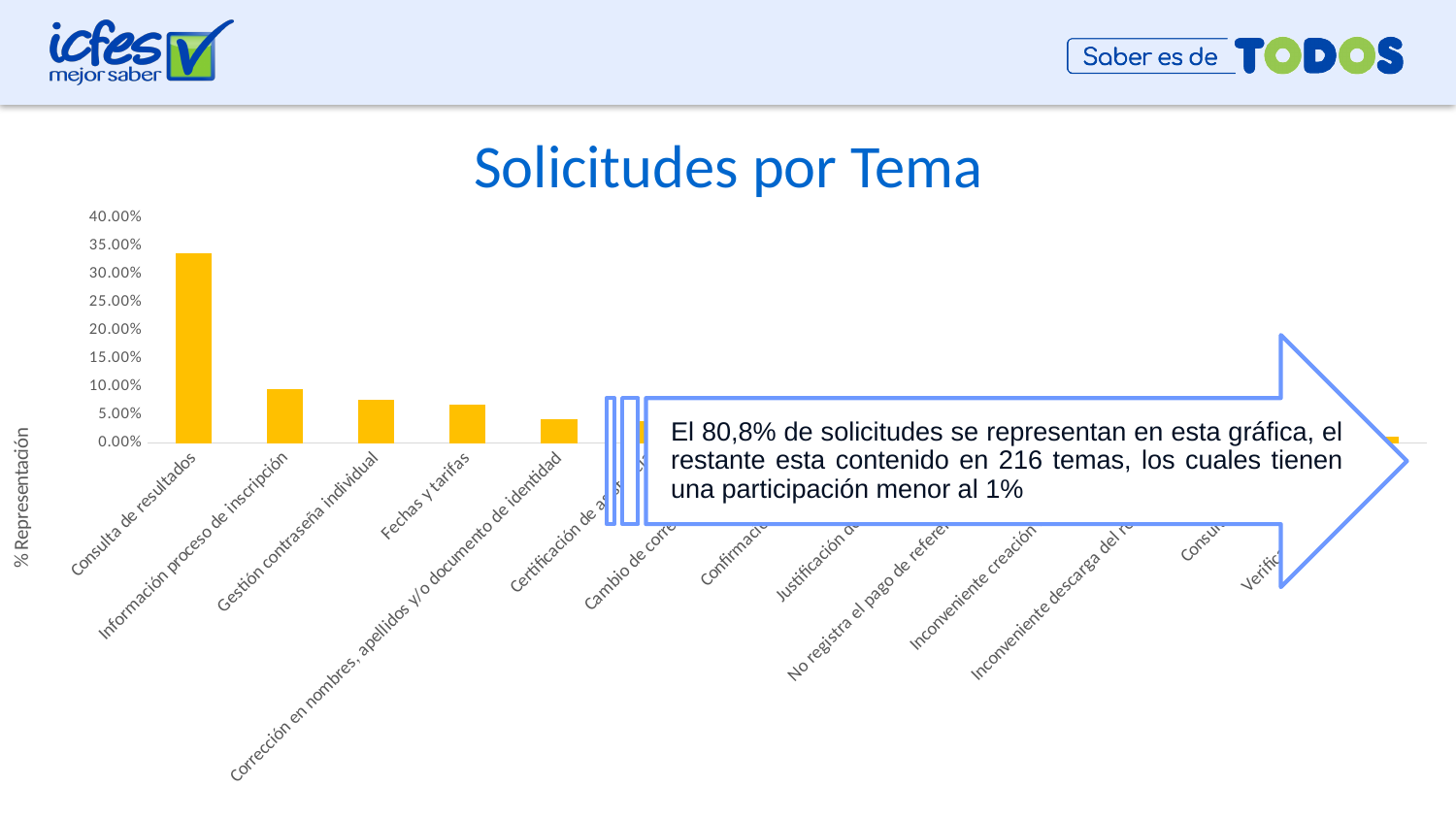
Is the value for Consulta de resultados greater or less than 30.00%? greater Is the value for Fechas y tarifas greater or less than 5.00%? greater Which is larger, the value for Consulta de resultados or the value for Información proceso de inscripción? Consulta de resultados What is the title of the chart? Solicitudes por Tema Which is larger, the value for Información proceso de inscripción or the value for Gestión contraseña individual? Información proceso de inscripción Is the value for Consulta de resultados greater or less than 35.00%? less What is the label on the vertical axis of the chart? % Representación What kind of chart is shown on the slide? Bar chart Do the bar values rise or fall moving from left to right along the x axis? fall Which category has the highest value in the chart? Consulta de resultados